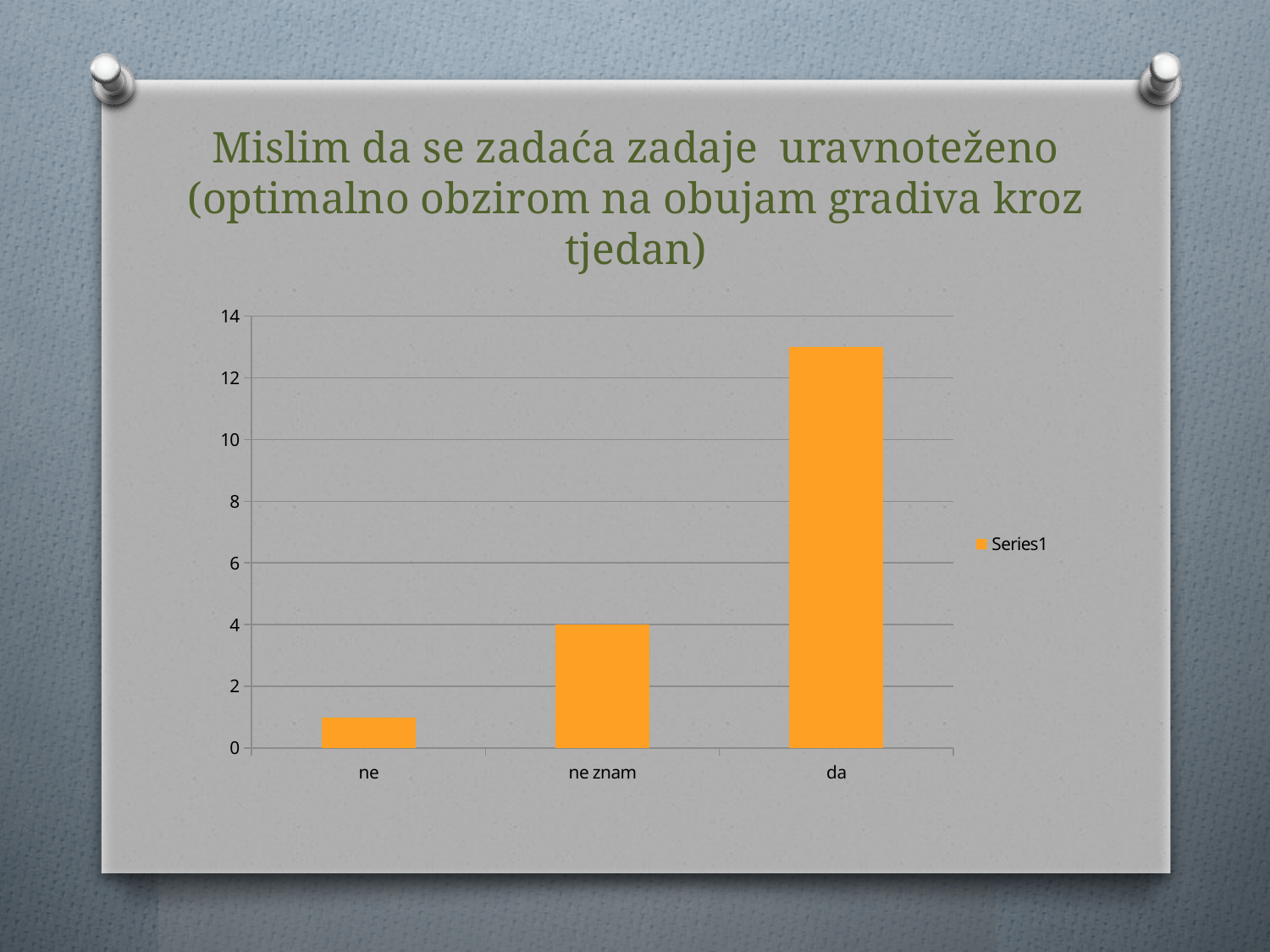
Which is larger, the value for "da" or the value for "ne znam"? da Is the value for "da" greater or less than 12? greater Which category has the highest value? da What kind of chart is shown on the slide? bar chart Which is larger, the value for "ne" or the value for "ne znam"? ne znam How many series does the legend list? 1 Is the value for "ne" greater or less than 2? less What is the name of the series shown in the legend? Series1 Do the values rise or fall from left to right along the x axis? rise How many categories are shown on the x axis? 3 Which category has the lowest value? ne What is the value for "ne znam"? 4